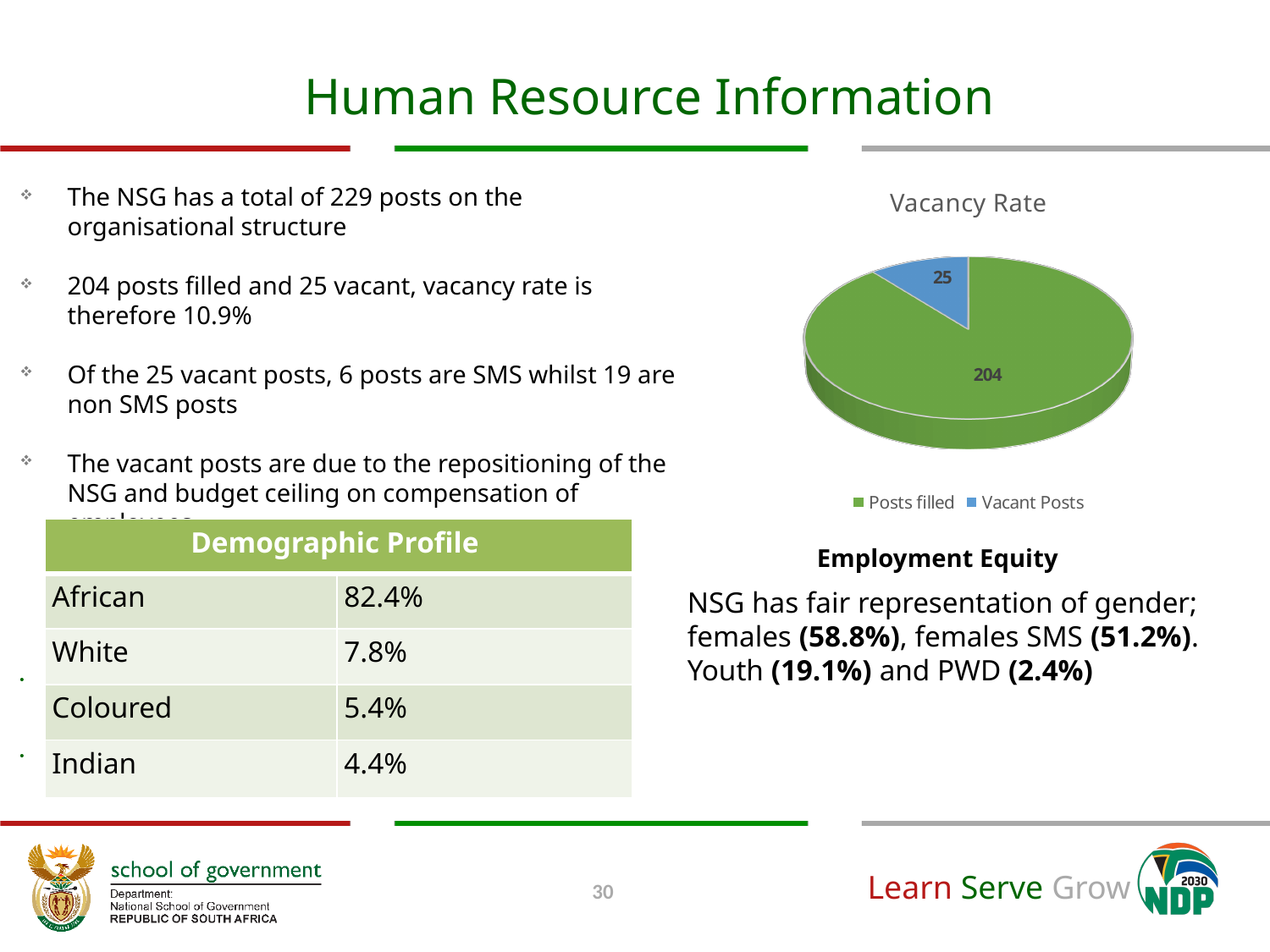
How many slices does the Vacancy Rate pie chart have? 2 What colour is the Vacant Posts slice in the Vacancy Rate pie chart? Blue In the Vacancy Rate pie chart, what is the value for Vacant Posts? 25 What share of the Vacancy Rate pie chart does the Vacant Posts slice represent? 10.9% In the Vacancy Rate pie chart, which is larger: Posts filled or Vacant Posts? Posts filled What kind of chart is shown under the title "Vacancy Rate"? Pie chart Which slice of the Vacancy Rate pie chart is the smallest? Vacant Posts What is the total of the two slices in the Vacancy Rate pie chart? 229 How many entries does the legend of the Vacancy Rate pie chart list? 2 In the Vacancy Rate pie chart, what is the difference between Posts filled and Vacant Posts? 179 Which slice of the Vacancy Rate pie chart is the largest? Posts filled In the Vacancy Rate pie chart, what is the value for Posts filled? 204